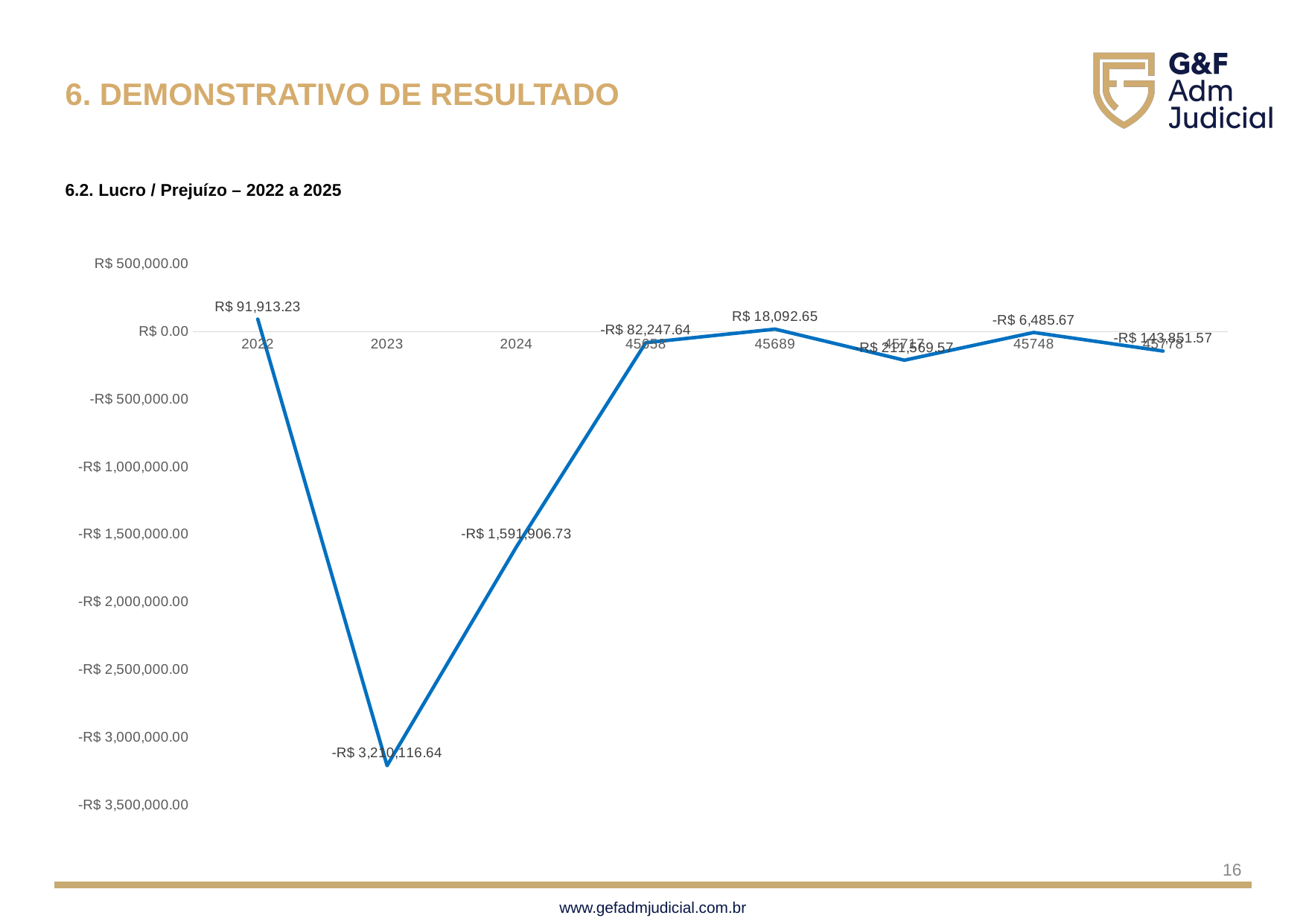
How many data points are plotted on the line? 8 What kind of chart is shown on the slide? line chart Does the line rise or fall from 2023 to 2024? rise Is the value for 2023 greater or less than -R$ 3,000,000.00? less Which category has the highest value? 2022 What is the value for the point labelled 45689? R$ 18,092.65 What is the value for 2022? R$ 91,913.23 Which is larger, the value for 2023 or the value for 2024? 2024 What is the value for 2024? -R$ 1,591,906.73 Which category has the lowest value? 2023 What is the value for the point labelled 45748? -R$ 6,485.67 What is the value for 2023? -R$ 3,210,116.64